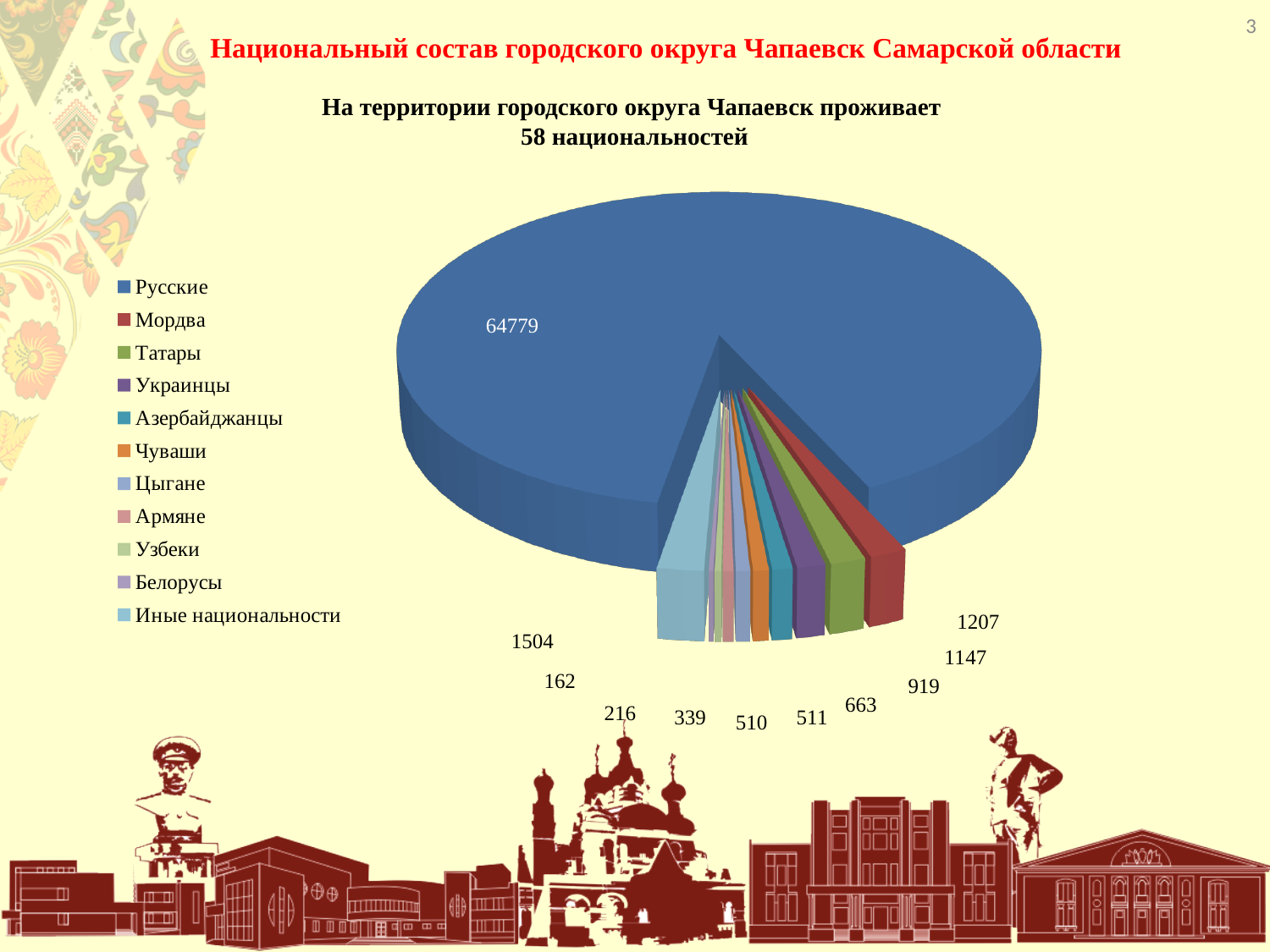
What is the difference between the values for Мордва and Татары? 60 What value is shown for Иные национальности on the pie chart? 1504 What colour is the slice for Русские? Blue What is the difference between the values for Иные национальности and Мордва? 297 What kind of chart is shown on the slide? Pie chart Which is larger, the value for Азербайджанцы or the value for Чуваши? Азербайджанцы Which nationality has the smallest value on the pie chart? Белорусы How many categories does the pie chart show? 11 Which nationality has the largest slice of the pie chart? Русские What value is shown for Украинцы on the pie chart? 919 What value is shown for Мордва on the pie chart? 1207 What value is shown for Русские on the pie chart? 64779